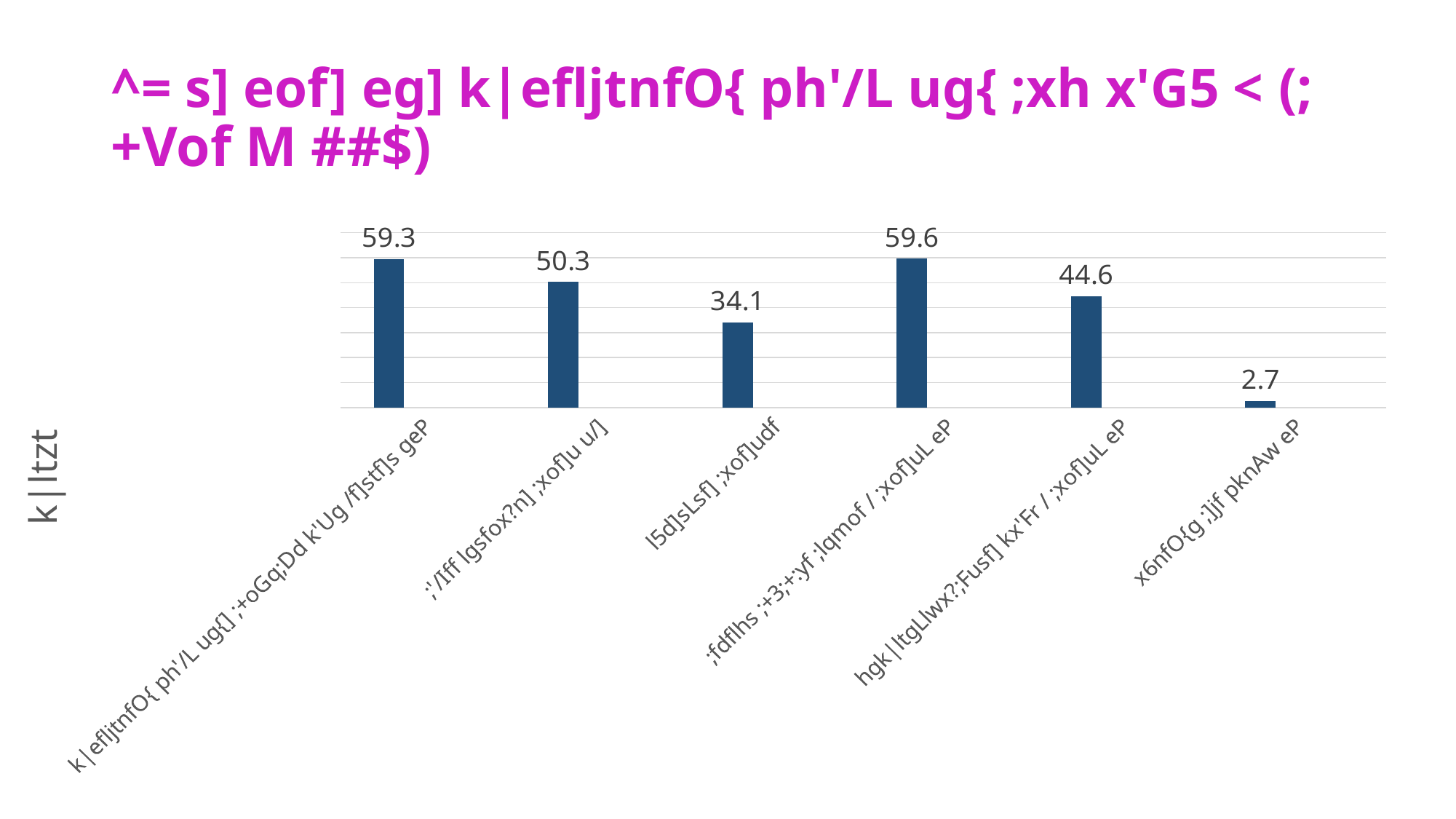
What is the value shown on the fourth bar from the left? 59.6 What is the value shown on the first bar from the left? 59.3 What is the difference between the values of the second bar and the third bar from the left? 16.2 What is the value shown on the last bar on the right? 2.7 What is the value shown on the fifth bar from the left? 44.6 Which bar has the highest value? the fourth bar from the left (59.6) What is the value shown on the third bar from the left? 34.1 Which is larger, the value of the first bar or the value of the fifth bar from the left? the first bar (59.3) Which bar has the lowest value? the last bar on the right (2.7) What is the value shown on the second bar from the left? 50.3 What type of chart is shown on the slide? bar chart How many bars are plotted in the chart? 6